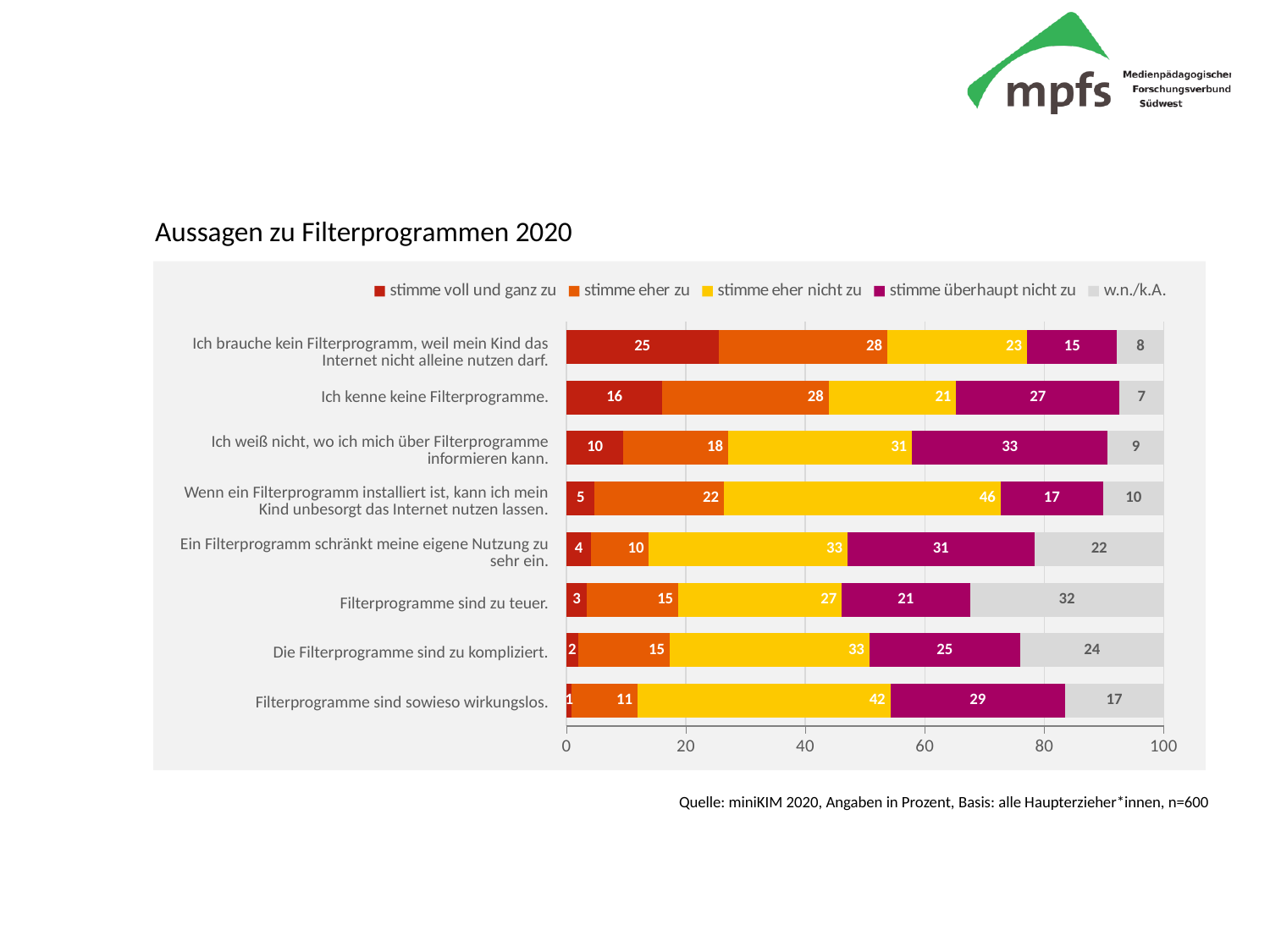
Which statement has the highest value for "stimme voll und ganz zu"? Ich brauche kein Filterprogramm, weil mein Kind das Internet nicht alleine nutzen darf. How many statements (categories) are shown in the chart? 8 Which is larger: the "stimme eher nicht zu" value for "Filterprogramme sind sowieso wirkungslos." or for "Die Filterprogramme sind zu kompliziert."? Filterprogramme sind sowieso wirkungslos. Which statement has the lowest value for "stimme voll und ganz zu"? Filterprogramme sind sowieso wirkungslos. How many series does the legend list? 5 Which statement has the highest value for "stimme überhaupt nicht zu"? Ich weiß nicht, wo ich mich über Filterprogramme informieren kann. What is the difference between the "stimme überhaupt nicht zu" values for "Ich kenne keine Filterprogramme." and "Ich brauche kein Filterprogramm, weil mein Kind das Internet nicht alleine nutzen darf."? 12 What is the value for "stimme voll und ganz zu" for the statement "Ich brauche kein Filterprogramm, weil mein Kind das Internet nicht alleine nutzen darf."? 25 What is the value for "w.n./k.A." for the statement "Filterprogramme sind zu teuer."? 32 What kind of chart is shown on the slide? Stacked bar chart What is the total of the stacked bar for "Ein Filterprogramm schränkt meine eigene Nutzung zu sehr ein."? 100 What is the value for "stimme eher nicht zu" for the statement "Wenn ein Filterprogramm installiert ist, kann ich mein Kind unbesorgt das Internet nutzen lassen."? 46